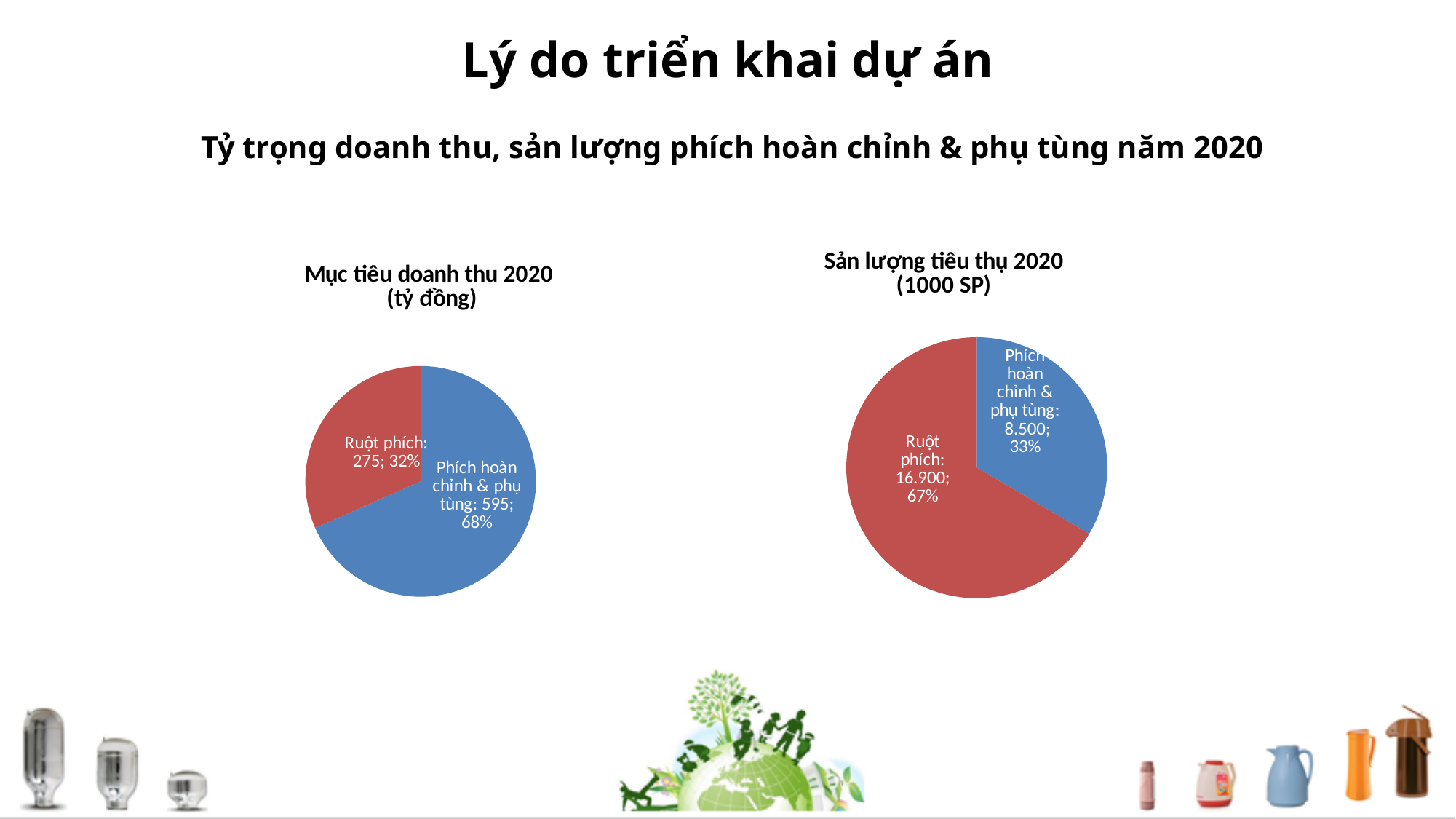
In the 'Sản lượng tiêu thụ 2020 (1000 SP)' chart, what share of the pie does Ruột phích take? 67% In the 'Mục tiêu doanh thu 2020 (tỷ đồng)' chart, which category is the smallest? Ruột phích How many slices does the 'Mục tiêu doanh thu 2020 (tỷ đồng)' pie chart have? 2 In the 'Mục tiêu doanh thu 2020 (tỷ đồng)' chart, what is the value for Phích hoàn chỉnh & phụ tùng? 595 In the 'Mục tiêu doanh thu 2020 (tỷ đồng)' chart, what is the value for Ruột phích? 275 In the 'Sản lượng tiêu thụ 2020 (1000 SP)' chart, what is the value for Ruột phích? 16.900 In the 'Sản lượng tiêu thụ 2020 (1000 SP)' chart, what is the value for Phích hoàn chỉnh & phụ tùng? 8.500 What kind of chart is the 'Sản lượng tiêu thụ 2020 (1000 SP)' chart? Pie chart In the 'Mục tiêu doanh thu 2020 (tỷ đồng)' chart, what is the difference between the Phích hoàn chỉnh & phụ tùng value and the Ruột phích value? 320 In the 'Mục tiêu doanh thu 2020 (tỷ đồng)' chart, what share of the pie does Phích hoàn chỉnh & phụ tùng take? 68% In the 'Mục tiêu doanh thu 2020 (tỷ đồng)' chart, what share of the pie does Ruột phích take? 32% In the 'Sản lượng tiêu thụ 2020 (1000 SP)' chart, which category is the largest? Ruột phích